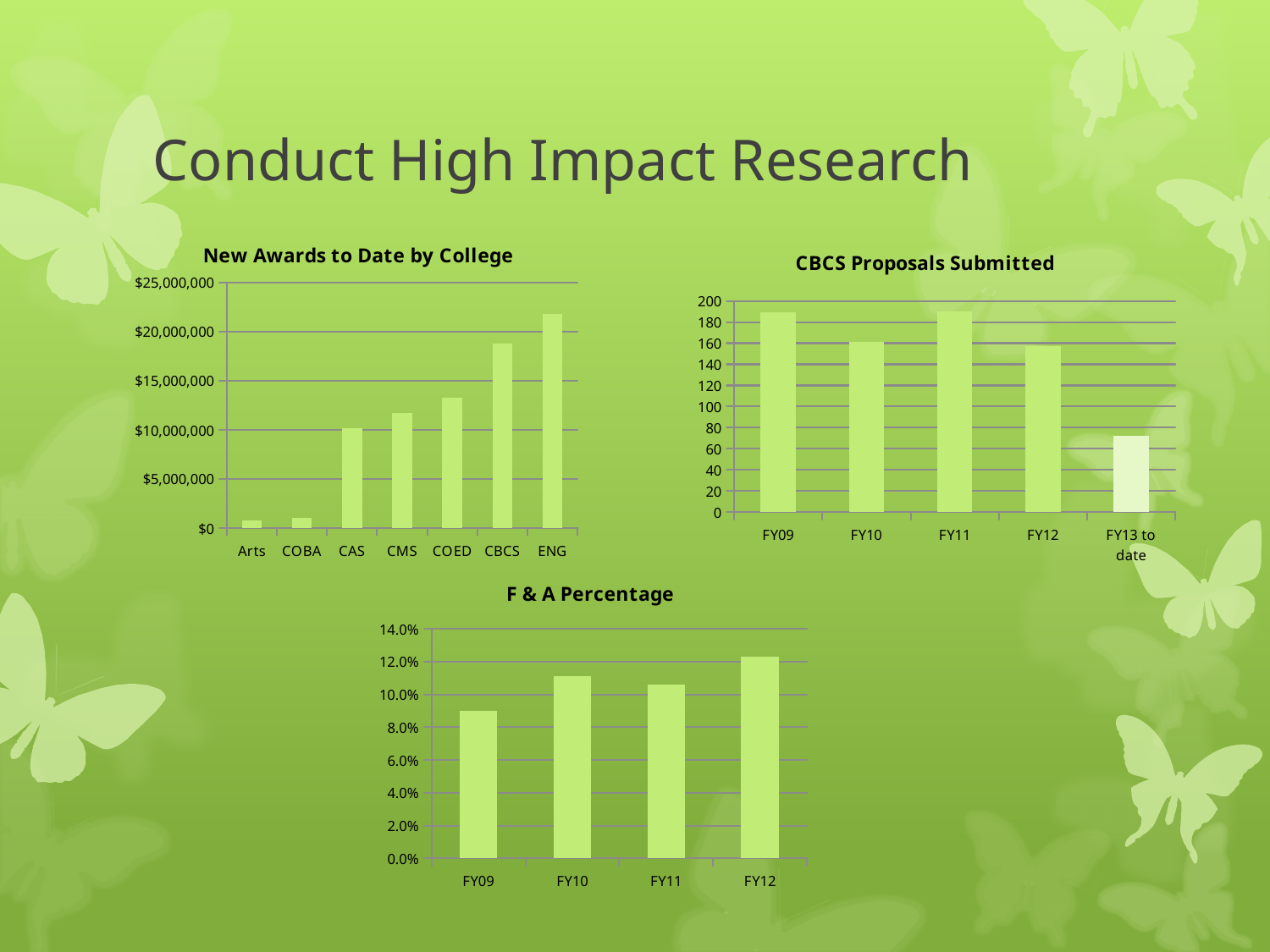
In the 'F & A Percentage' chart, which fiscal year has the lowest value? FY09 In the 'F & A Percentage' chart, is the value for FY09 greater or less than 10.0%? less In the 'New Awards to Date by College' chart, how many colleges are shown on the x axis? 7 In the 'CBCS Proposals Submitted' chart, which category has the lowest value? FY13 to date In the 'F & A Percentage' chart, which fiscal year has the highest value? FY12 What type of chart is the 'F & A Percentage' chart? bar chart In the 'CBCS Proposals Submitted' chart, how many fiscal-year categories are shown? 5 In the 'New Awards to Date by College' chart, which is larger, the value for CMS or the value for CBCS? CBCS In the 'New Awards to Date by College' chart, is the value for COED greater or less than $15,000,000? less In the 'CBCS Proposals Submitted' chart, is the value for FY13 to date greater or less than 80? less In the 'New Awards to Date by College' chart, which college has the highest value? ENG